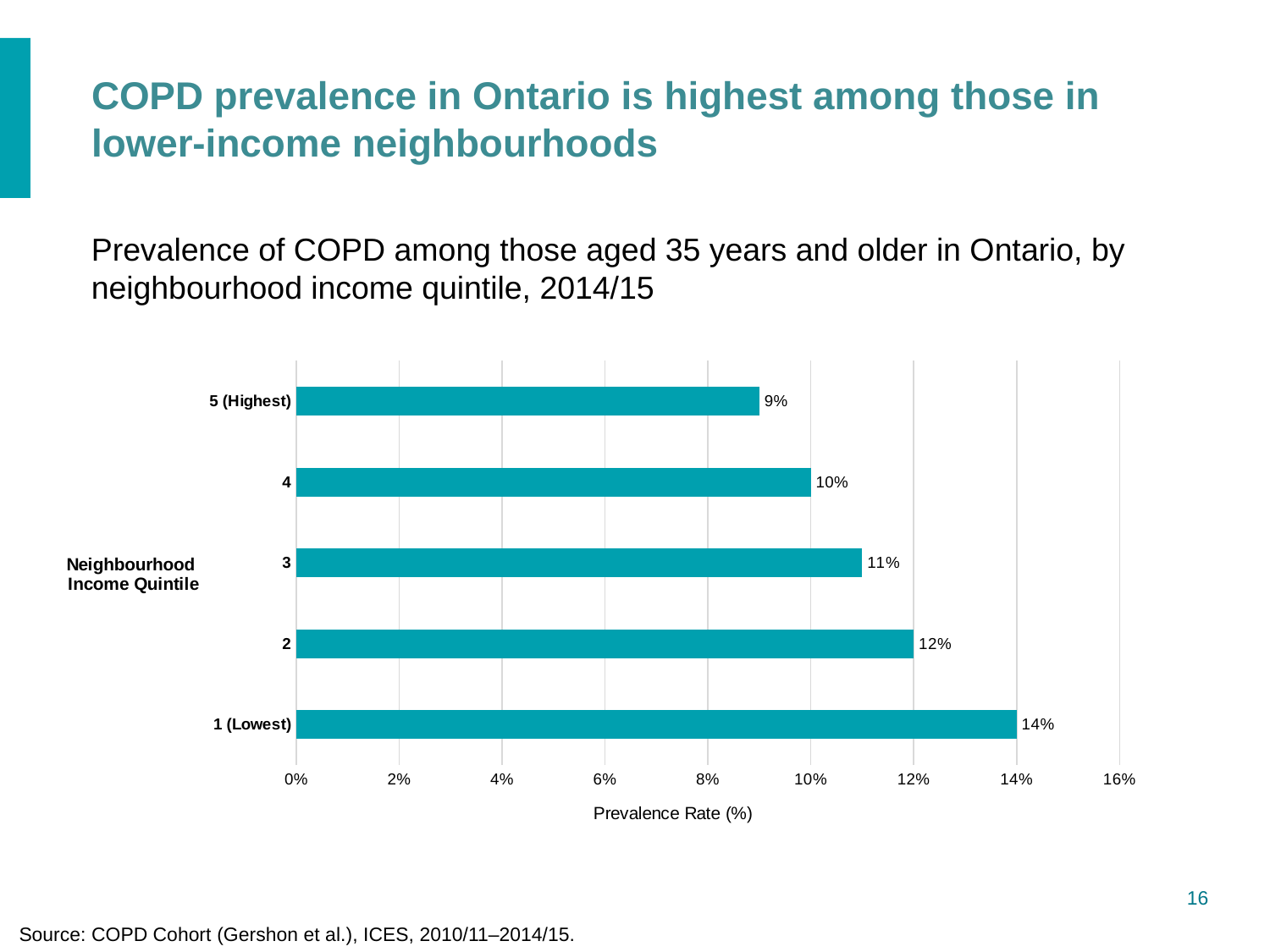
How many neighbourhood income quintiles are shown in the chart? 5 What is the difference in COPD prevalence rate between quintile 2 and quintile 4? 2% What type of chart is used to show COPD prevalence by neighbourhood income quintile? Bar chart What is the COPD prevalence rate for neighbourhood income quintile 3? 11% Which neighbourhood income quintile has the lowest COPD prevalence rate? 5 (Highest) What is the label of the horizontal axis of the chart? Prevalence Rate (%) Is the COPD prevalence rate for quintile 3 greater or less than 10%? greater What is the COPD prevalence rate for neighbourhood income quintile 1 (Lowest)? 14% What is the COPD prevalence rate for neighbourhood income quintile 5 (Highest)? 9% Which neighbourhood income quintile has the highest COPD prevalence rate? 1 (Lowest) What is the difference in COPD prevalence rate between quintile 1 (Lowest) and quintile 5 (Highest)? 5% Which has a higher COPD prevalence rate, quintile 2 or quintile 4? Quintile 2